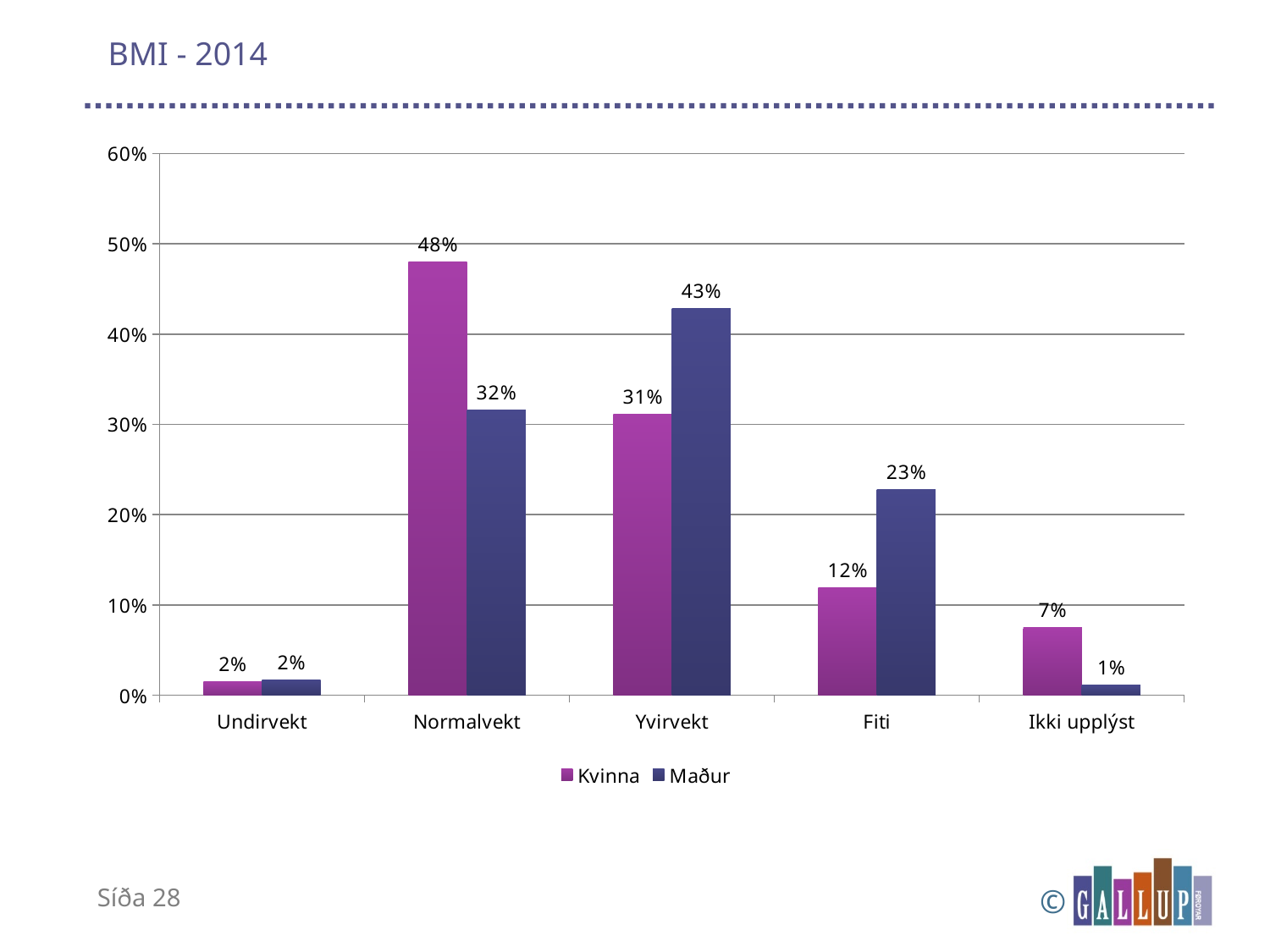
Which category has the highest value for Kvinna? Normalvekt In the Fiti category, which series has the larger value, Kvinna or Maður? Maður What is the difference between the Kvinna and Maður values in the Normalvekt category? 16% How many series does the legend list? 2 What is the value for Kvinna in the Ikki upplýst category? 7% How many categories are shown on the x axis? 5 What kind of chart is shown on the slide? Bar chart What is the value for Maður in the Fiti category? 23% Which category has the lowest value for Maður? Ikki upplýst Is the value for Maður in the Normalvekt category greater or less than 30%? greater What is the value for Kvinna in the Normalvekt category? 48% What is the value for Maður in the Yvirvekt category? 43%